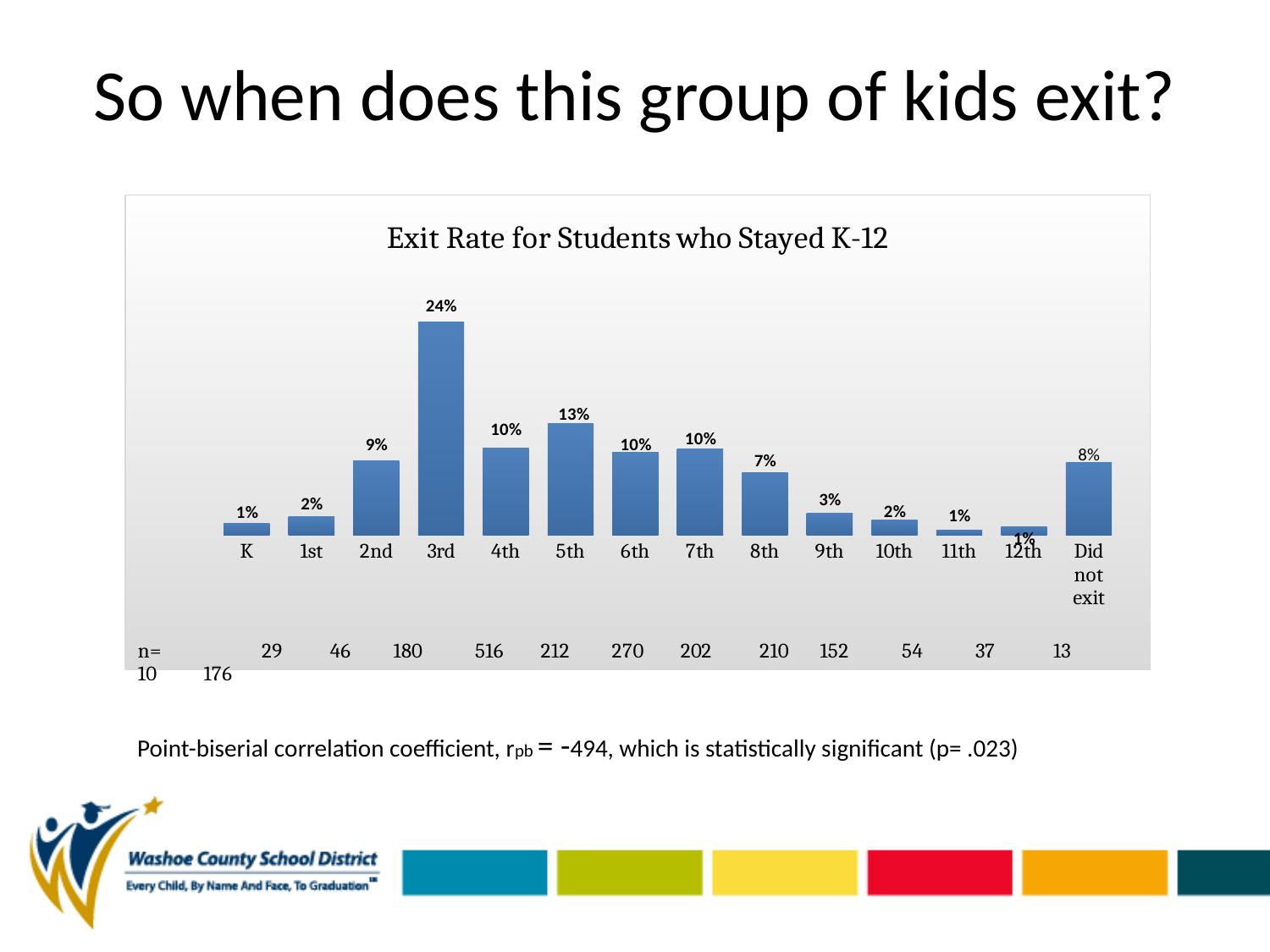
What is the title of the chart? Exit Rate for Students who Stayed K-12 What is the exit rate for 5th grade? 13% What is the difference between the exit rate for 3rd grade and 5th grade? 11% Which grade has the highest exit rate? 3rd What is the value for the 'Did not exit' category? 8% Which has a higher exit rate, 5th grade or 8th grade? 5th What is the exit rate for 3rd grade? 24% What type of chart is shown on the slide? bar chart What is the exit rate for 9th grade? 3% How many categories are shown on the x axis of the chart? 14 Do the exit rates rise or fall from 3rd grade through 12th grade? fall Which has a higher exit rate, 2nd grade or 9th grade? 2nd